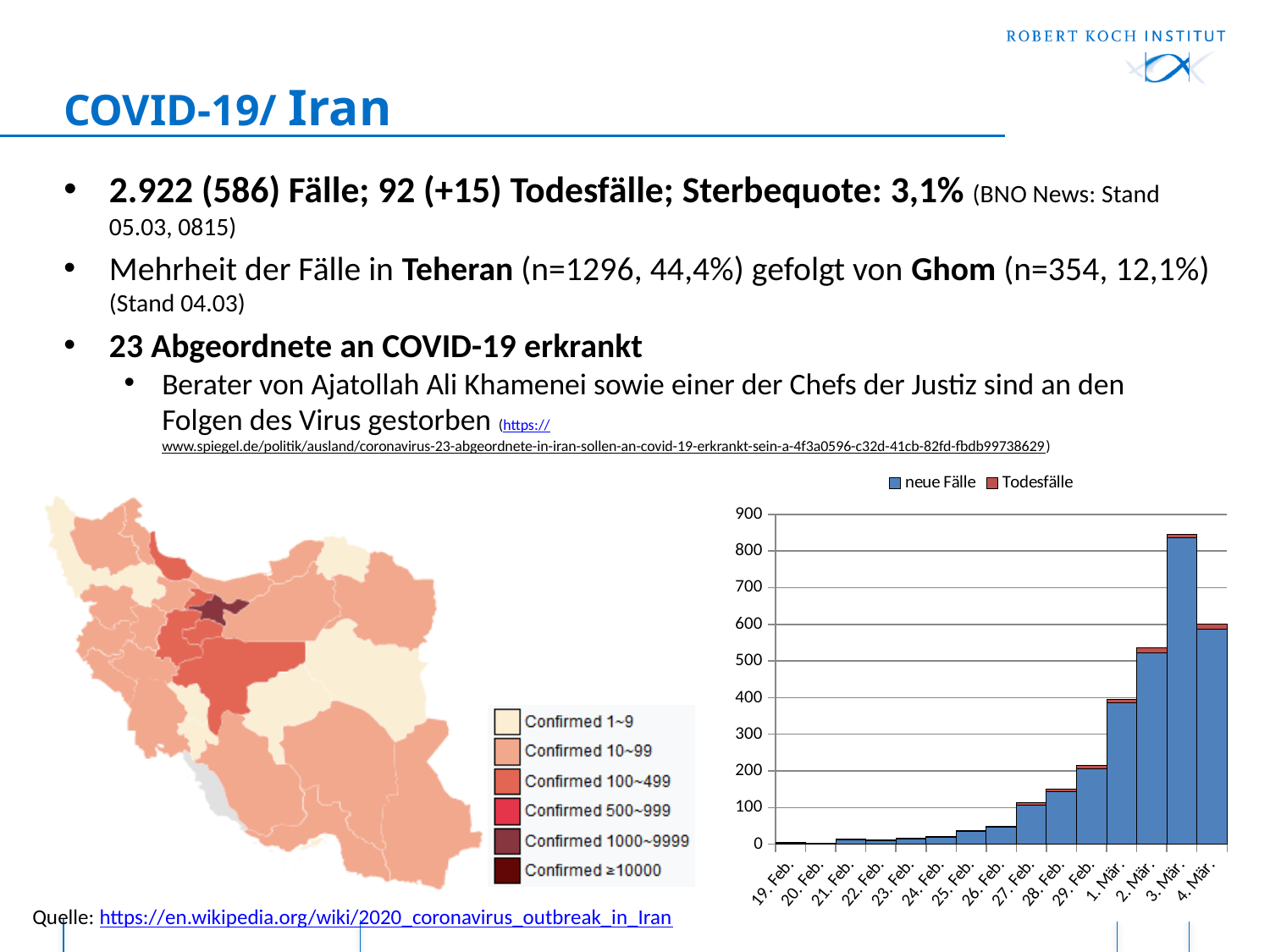
What kind of chart is shown on the slide? bar chart Is the total bar for 28. Feb. greater or less than 100? greater How many dates are shown along the x axis of the chart? 15 Which bar is taller, 3. Mär. or 2. Mär.? 3. Mär. Is the total bar for 3. Mär. greater or less than 800? greater How many series does the chart legend list? 2 Which date has the highest bar in the chart? 3. Mär. Is the total bar for 2. Mär. greater or less than 500? greater Do the bars generally rise or fall from 19. Feb. to 3. Mär.? rise What are the two series named in the chart legend? neue Fälle, Todesfälle Which colour represents the series 'neue Fälle' in the chart? blue